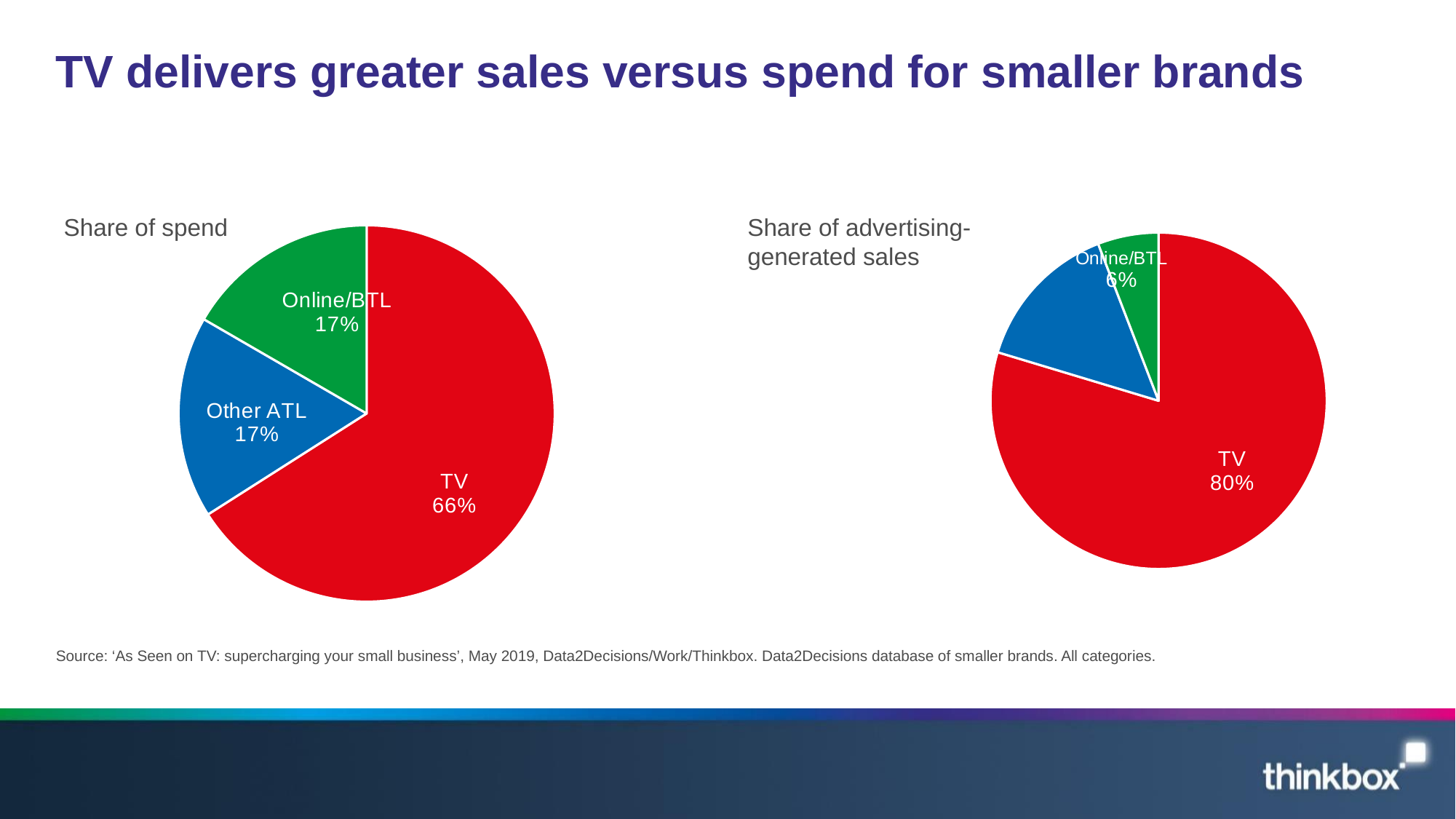
What kind of chart is used on the left of the slide? Pie chart Is the TV share larger in the 'Share of spend' chart or in the 'Share of advertising-generated sales' chart? Share of advertising-generated sales In the 'Share of spend' pie chart, what is the value for TV? 66% In the 'Share of advertising-generated sales' pie chart, what is the value for TV? 80% In the 'Share of spend' pie chart, what is the difference between the TV share and the Other ATL share? 49 percentage points In the 'Share of spend' pie chart, which category has the largest share? TV In the 'Share of spend' pie chart, what is the value for Online/BTL? 17% In the 'Share of spend' pie chart, what is the value for Other ATL? 17% In the 'Share of advertising-generated sales' pie chart, what is the value for Online/BTL? 6% In the 'Share of advertising-generated sales' pie chart, which labelled category has the smallest share? Online/BTL What is the title of the chart on the right of the slide? Share of advertising-generated sales How many slices does the 'Share of spend' pie chart have? 3